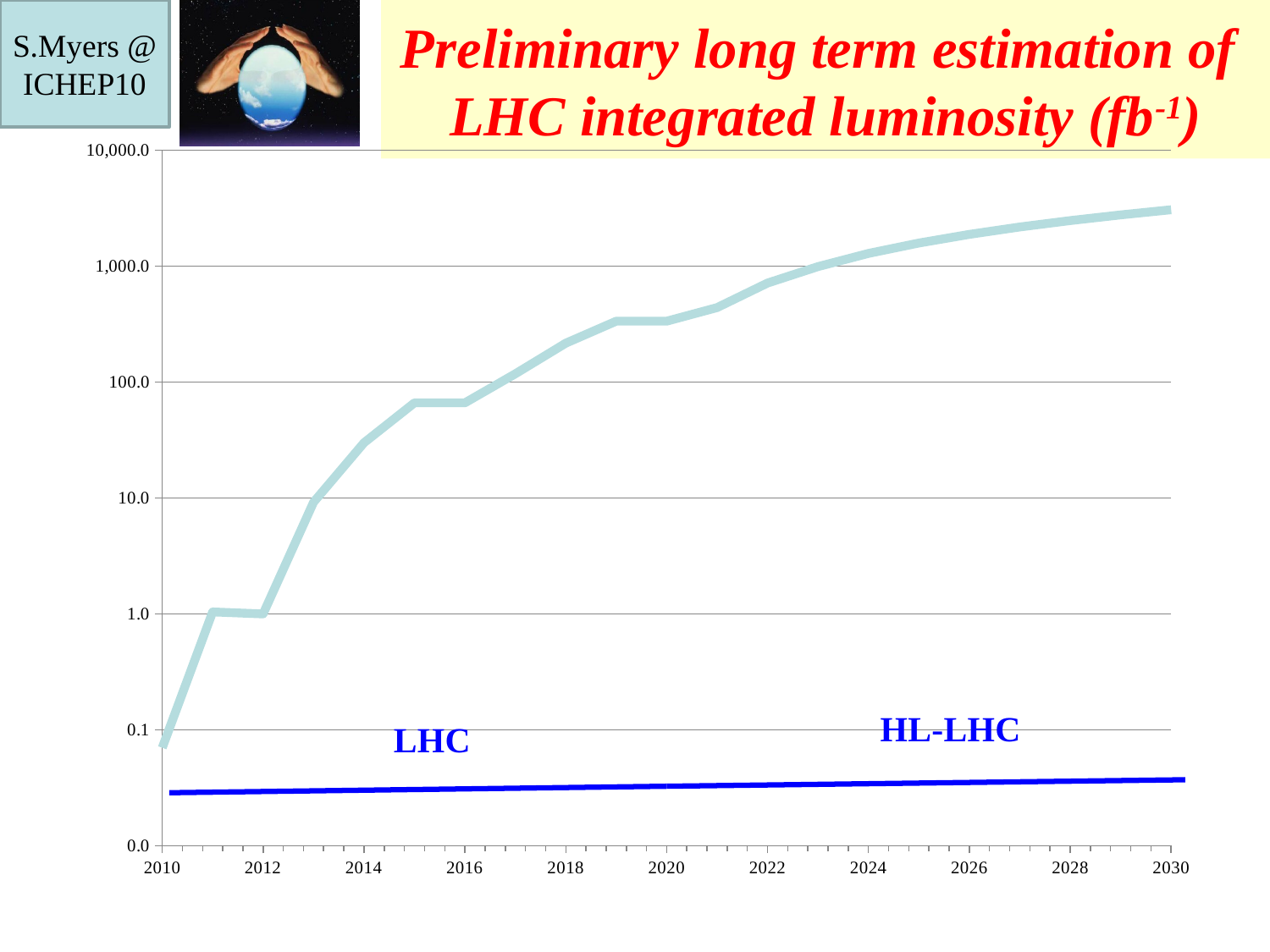
Is the value of the light blue line in 2030 greater or less than 1,000? greater Does the light blue line rise or fall from 2010 to 2030? rises Is the value of the light blue line in 2015 greater or less than 100? less Is the value of the light blue line in 2020 greater or less than 100? greater Which year has the lowest value on the light blue line? 2010 Which is larger, the value of the light blue line in 2015 or in 2020? 2020 What kind of chart is shown on the slide? line chart What is the highest value labelled on the y axis? 10,000.0 Which year has the highest value on the light blue line? 2030